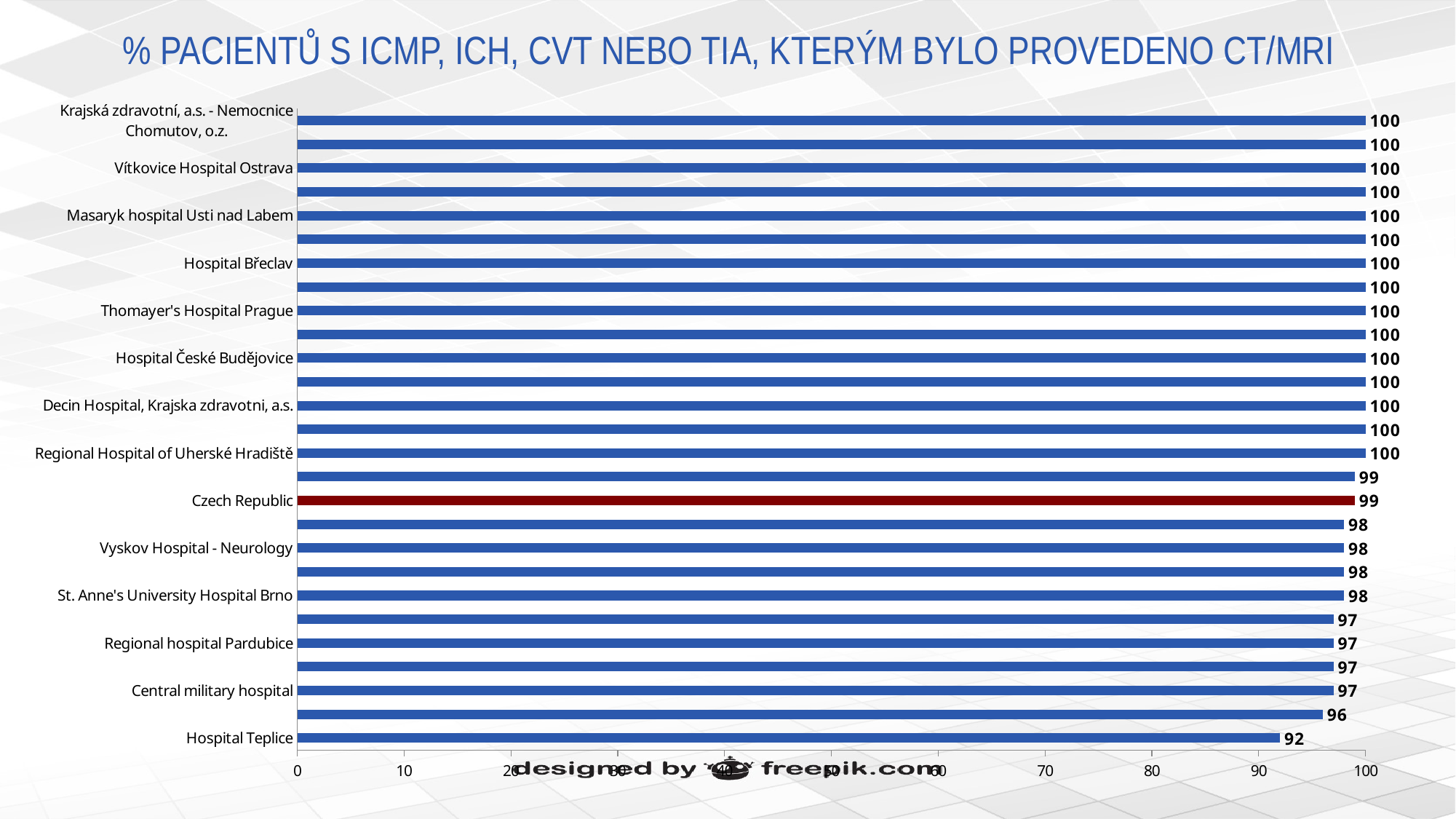
Which labelled category has the lowest value? Hospital Teplice What is the value for Regional hospital Pardubice? 97 Is the value for Hospital Teplice greater or less than 90? greater Which is larger, the value for St. Anne's University Hospital Brno or the value for Hospital Teplice? St. Anne's University Hospital Brno What is the value for Masaryk hospital Usti nad Labem? 100 What is the difference between the values for Czech Republic and Hospital Teplice? 7 What is the value for Vyskov Hospital - Neurology? 98 What kind of chart is shown on the slide? bar chart Which bar is drawn in a different colour (dark red) from the others? Czech Republic What is the title of the chart? % PACIENTŮ S ICMP, ICH, CVT NEBO TIA, KTERÝM BYLO PROVEDENO CT/MRI What is the value for Hospital Teplice? 92 What is the value for Czech Republic? 99